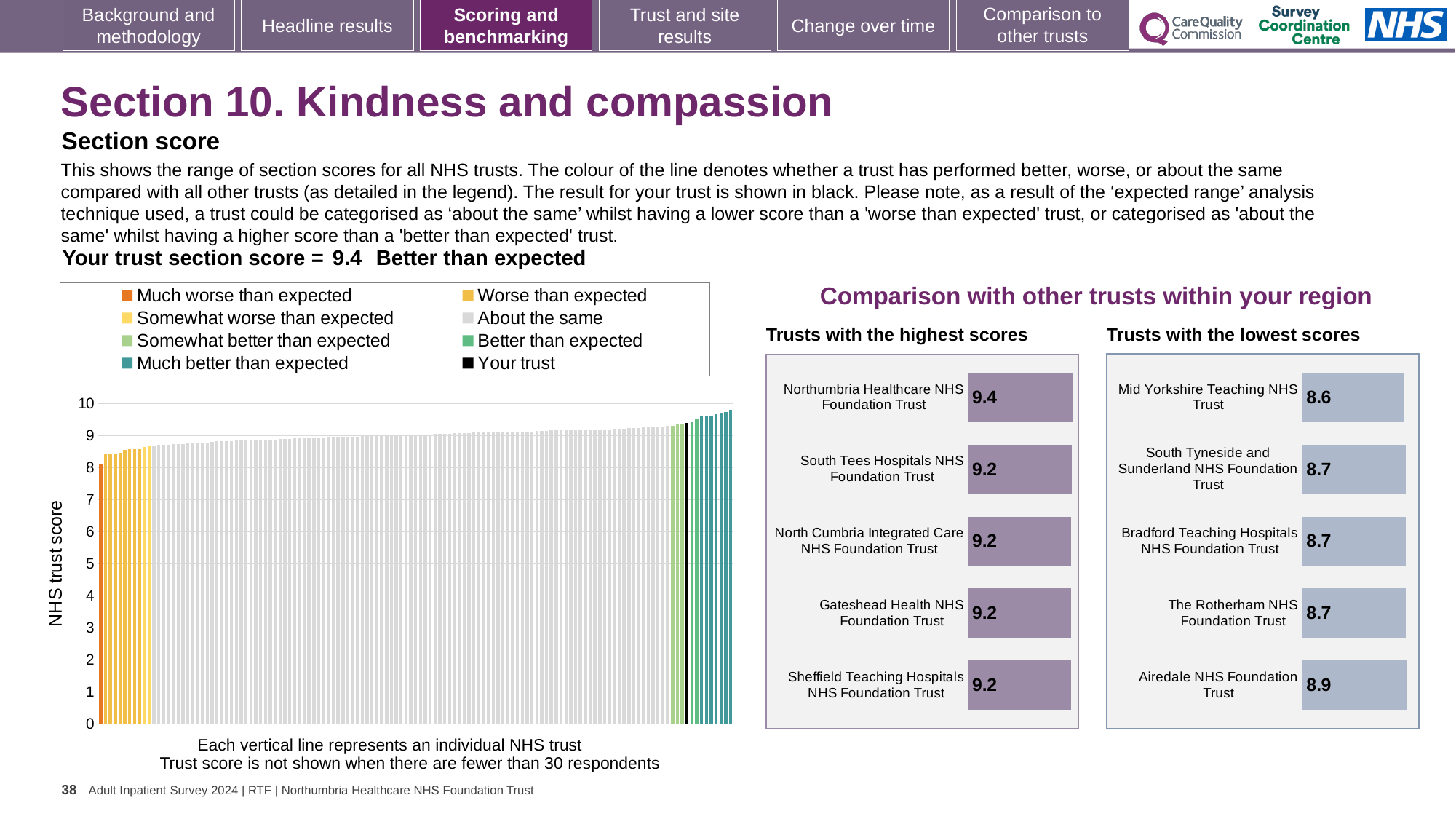
How many entries does the legend of the NHS trust score chart on the left list? 8 How many trusts are listed in the 'Trusts with the highest scores' chart? 5 What kind of chart is the NHS trust score chart on the left of the slide? Bar chart In the 'Trusts with the lowest scores' chart, what is the difference between the scores of Airedale NHS Foundation Trust and Mid Yorkshire Teaching NHS Trust? 0.3 In the 'Trusts with the highest scores' chart, what is the score for Northumbria Healthcare NHS Foundation Trust? 9.4 In the 'Trusts with the lowest scores' chart, which has the higher score: Airedale NHS Foundation Trust or Mid Yorkshire Teaching NHS Trust? Airedale NHS Foundation Trust In the 'Trusts with the lowest scores' chart, what is the score for Mid Yorkshire Teaching NHS Trust? 8.6 In the 'Trusts with the lowest scores' chart, which trust has the lowest score? Mid Yorkshire Teaching NHS Trust In the 'Trusts with the highest scores' chart, what is the difference between the scores of Northumbria Healthcare NHS Foundation Trust and South Tees Hospitals NHS Foundation Trust? 0.2 In the 'Trusts with the highest scores' chart, which trust has the highest score? Northumbria Healthcare NHS Foundation Trust In the 'Trusts with the lowest scores' chart, what is the score for Airedale NHS Foundation Trust? 8.9